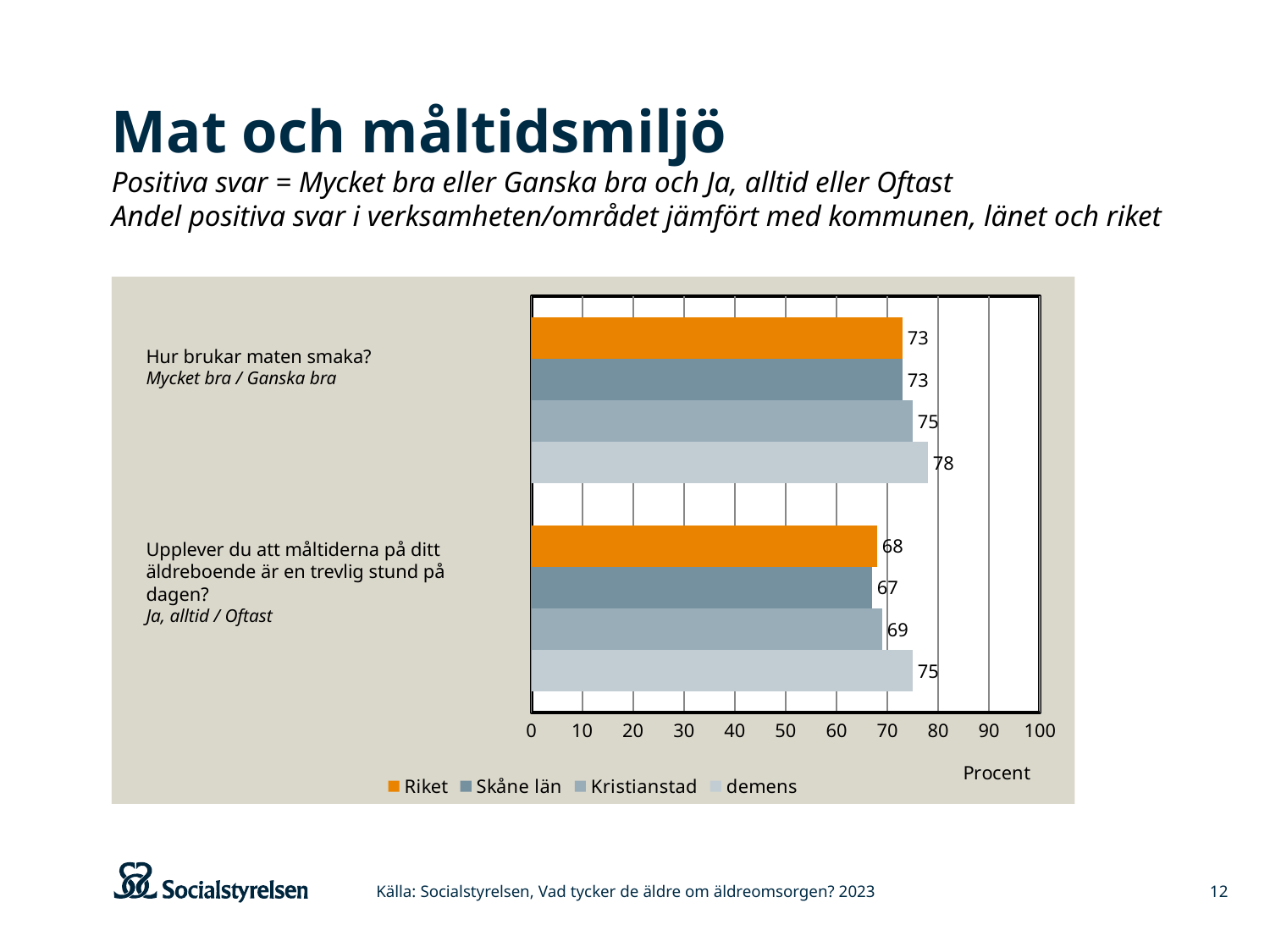
What is the value for Kristianstad for the question "Upplever du att måltiderna på ditt äldreboende är en trevlig stund på dagen?"? 69 Which series has the highest value for the question "Upplever du att måltiderna på ditt äldreboende är en trevlig stund på dagen?"? demens What kind of chart is shown on the slide? bar chart How many series does the legend list? 4 What is the difference between the demens value and the Riket value for the question "Upplever du att måltiderna på ditt äldreboende är en trevlig stund på dagen?"? 7 Which series has the lowest value for the question "Upplever du att måltiderna på ditt äldreboende är en trevlig stund på dagen?"? Skåne län What is the label of the x axis? Procent What is the value for Skåne län for the question "Upplever du att måltiderna på ditt äldreboende är en trevlig stund på dagen?"? 67 What is the difference between the demens value and the Kristianstad value for the question "Hur brukar maten smaka?"? 3 What is the value for Riket for the question "Hur brukar maten smaka?"? 73 What is the value for demens for the question "Hur brukar maten smaka?"? 78 How many questions (categories) are shown in the chart? 2